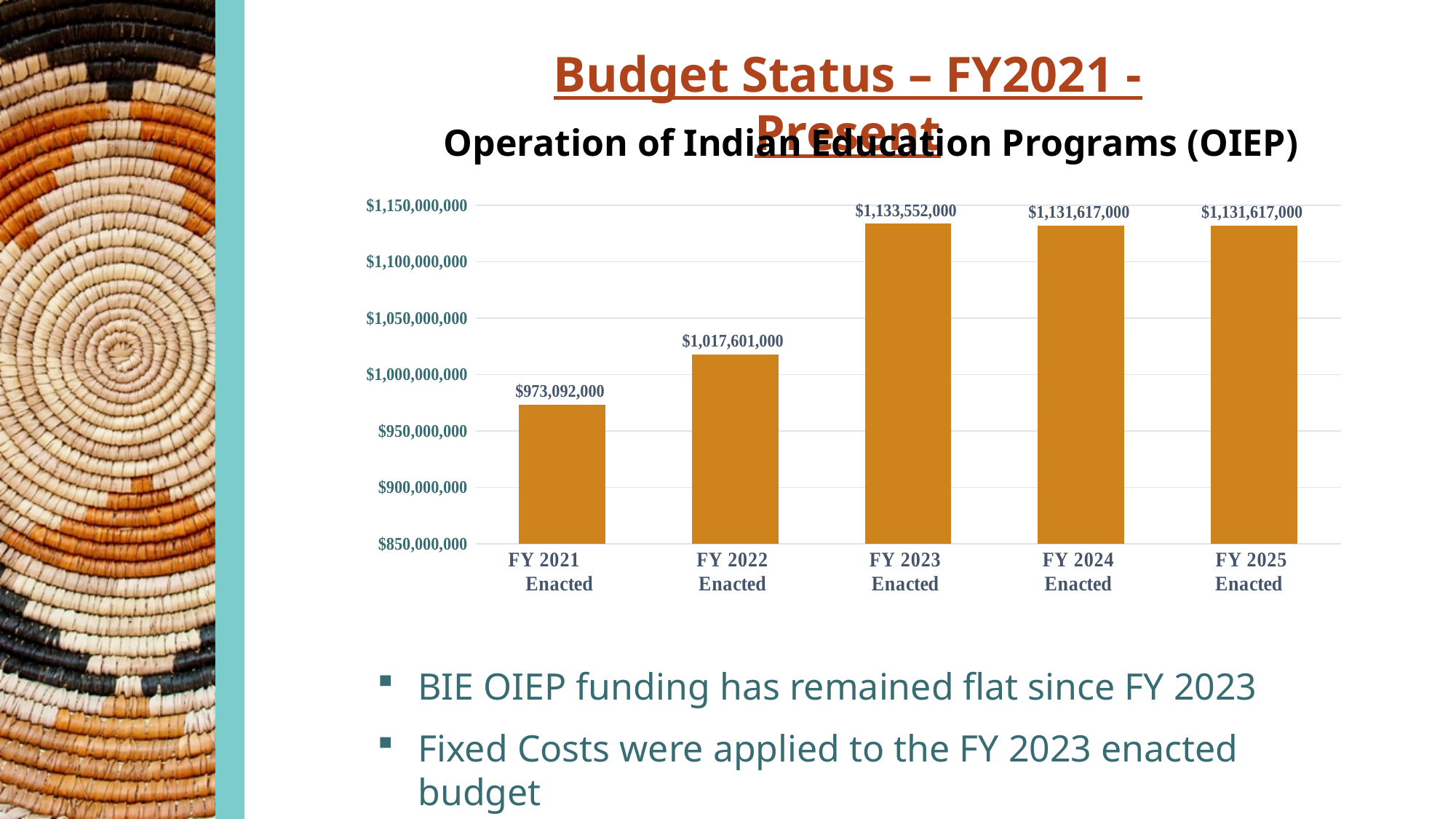
Do the values rise or fall from FY 2021 Enacted to FY 2023 Enacted? rise Which is larger, the value for FY 2022 Enacted or FY 2021 Enacted? FY 2022 Enacted Is the value for FY 2021 Enacted greater or less than $1,000,000,000? less What is the value for FY 2021 Enacted? $973,092,000 What is the difference between the FY 2023 Enacted and FY 2024 Enacted values? $1,935,000 What is the value for FY 2023 Enacted? $1,133,552,000 Which fiscal year has the lowest enacted value? FY 2021 Enacted How many fiscal years are shown on the chart? 5 What is the value for FY 2025 Enacted? $1,131,617,000 What is the difference between the FY 2022 Enacted and FY 2021 Enacted values? $44,509,000 Which fiscal year has the highest enacted value? FY 2023 Enacted What kind of chart is shown on the slide? bar chart